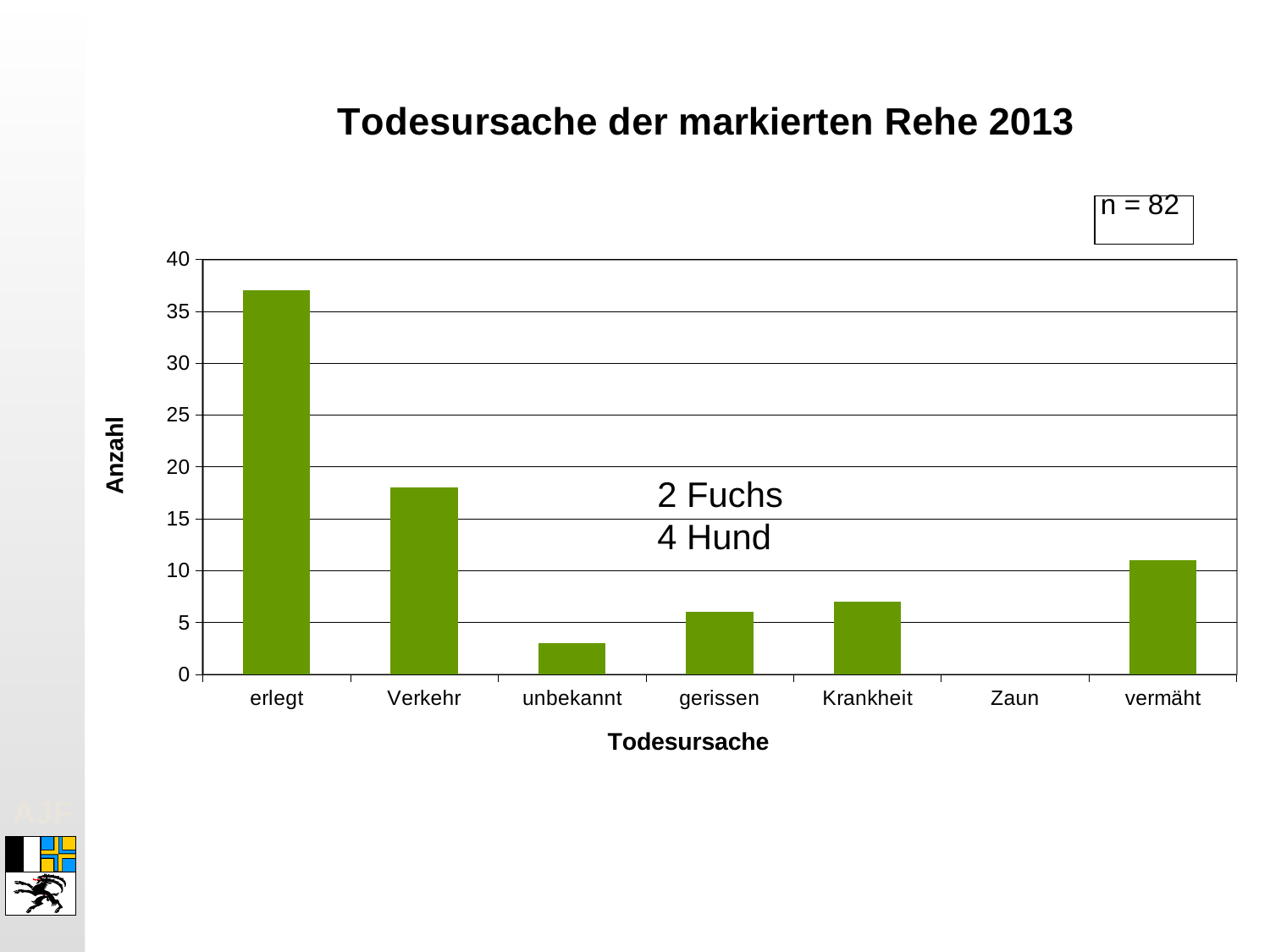
Is the value for unbekannt greater or less than 5? less What kind of chart is shown on the slide? bar chart How many categories (Todesursachen) are shown on the x axis? 7 Is the value for Verkehr greater or less than 20? less Which has a larger Anzahl, Verkehr or vermäht? Verkehr Is the value for vermäht greater or less than 10? greater What is the title of the chart? Todesursache der markierten Rehe 2013 What sample size (n) is stated in the box on the chart? n = 82 What is the value for Zaun? 0 Which Todesursache has the lowest Anzahl? Zaun Which Todesursache has the highest Anzahl? erlegt